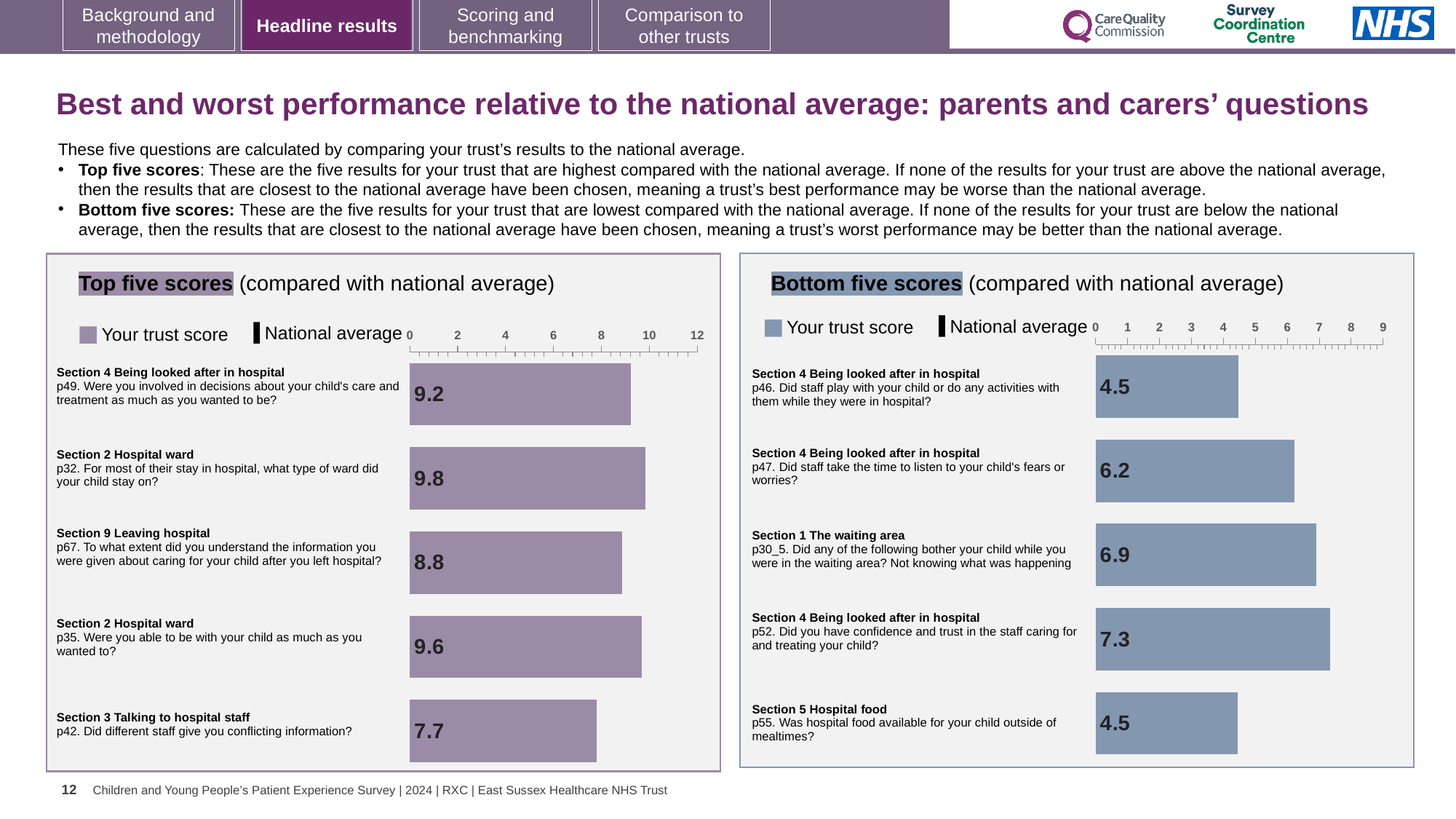
How many entries does the legend of the 'Top five scores' chart list? 2 In the 'Bottom five scores' chart, which has the larger score: p47 or p30_5? p30_5 In the 'Bottom five scores' chart, what is the difference between the scores for p52 and p46? 2.8 In the 'Top five scores' chart, what is the trust score for p32 (what type of ward did your child stay on)? 9.8 What type of chart is used for the 'Bottom five scores'? Bar chart In the 'Bottom five scores' chart, which question has the highest trust score? p52 (confidence and trust in the staff) In the 'Top five scores' chart, which question has the highest trust score? p32 (what type of ward did your child stay on) In the 'Top five scores' chart, what is the difference between the scores for p32 and p42? 2.1 How many bars are shown in the 'Top five scores' chart? 5 In the 'Bottom five scores' chart, what is the trust score for p52 (confidence and trust in the staff caring for and treating your child)? 7.3 In the 'Top five scores' chart, which question has the lowest trust score? p42 (did different staff give you conflicting information) In the 'Bottom five scores' chart, is the score for p46 (did staff play with your child) greater or less than 5? less